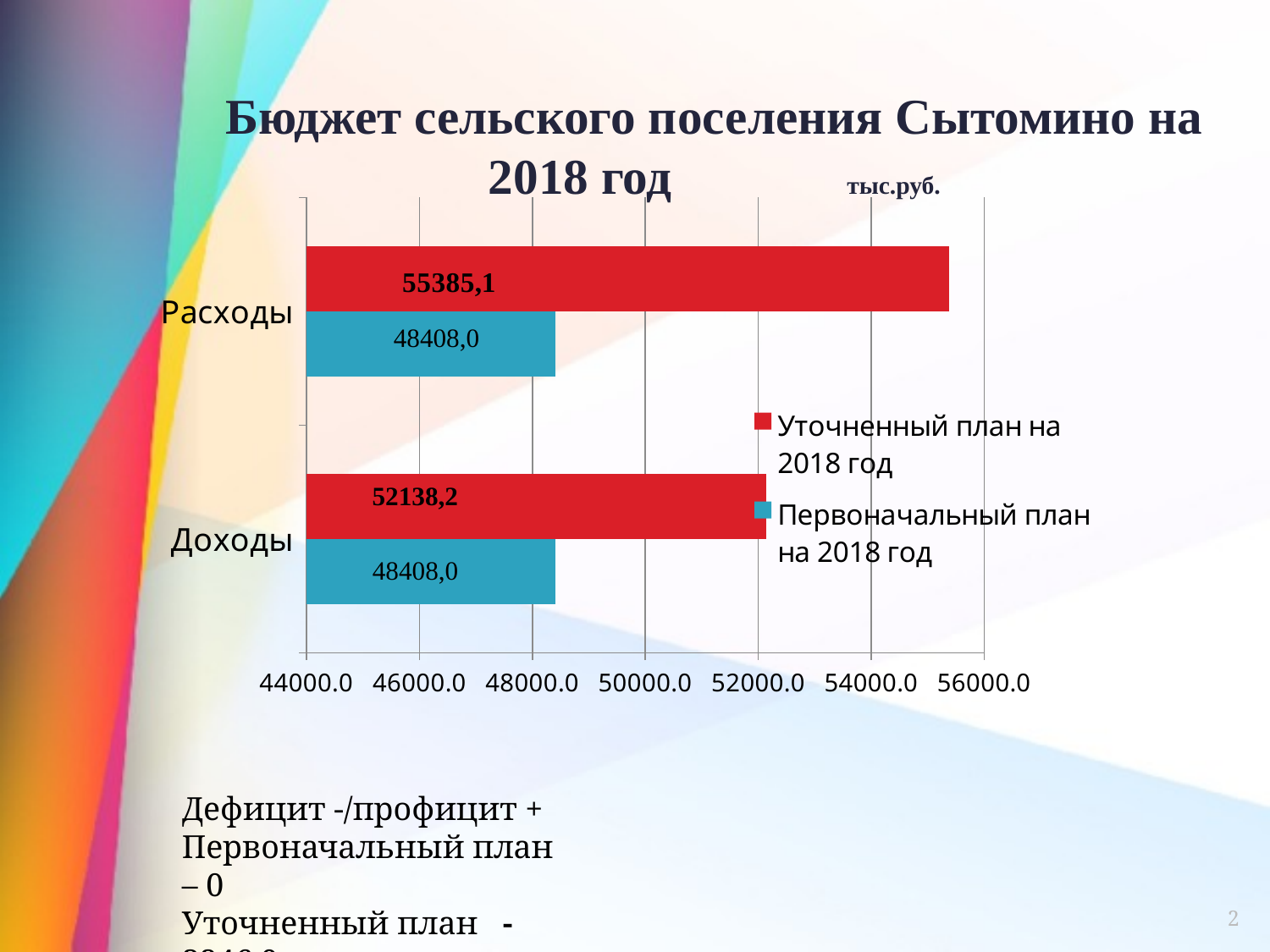
How many categories are shown on the chart? 2 What unit is indicated next to the chart title? тыс.руб. What is the value of Уточненный план на 2018 год for Расходы? 55385,1 What is the value of Первоначальный план на 2018 год for Расходы? 48408,0 Which is larger for Расходы: Уточненный план на 2018 год or Первоначальный план на 2018 год? Уточненный план на 2018 год What is the value of Первоначальный план на 2018 год for Доходы? 48408,0 What is the difference between Уточненный план на 2018 год for Расходы and for Доходы? 3246,9 What type of chart is shown on the slide? bar chart What is the value of Уточненный план на 2018 год for Доходы? 52138,2 How many series does the legend list? 2 Which category has the highest value for Уточненный план на 2018 год? Расходы What is the difference between Уточненный план на 2018 год and Первоначальный план на 2018 год for Доходы? 3730,2